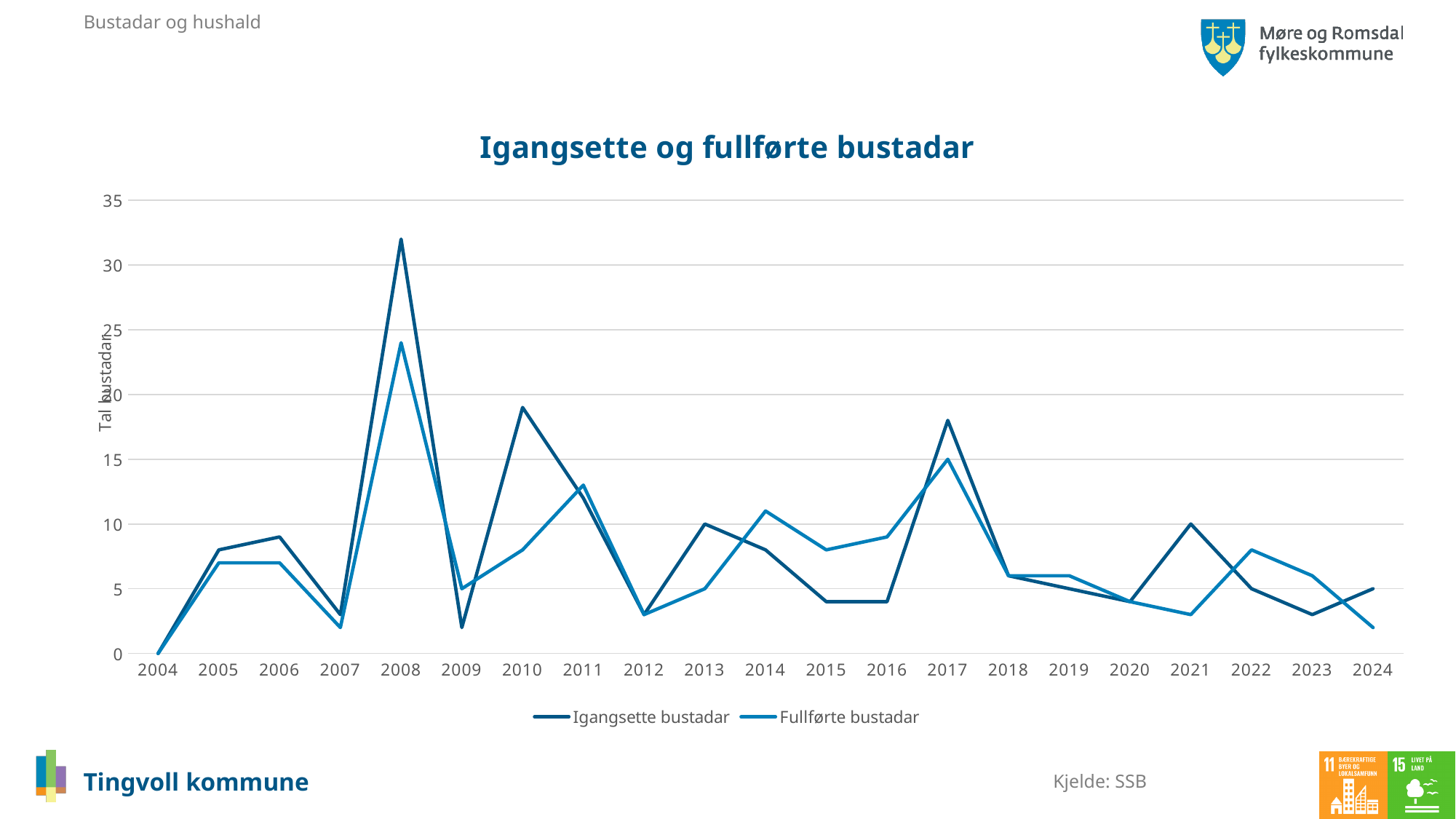
What is the value for Igangsette bustadar in 2013? 10 What kind of chart is shown on the slide? line chart What is the title of the chart? Igangsette og fullførte bustadar In which year does the Igangsette bustadar series reach its highest value? 2008 Is the value for Igangsette bustadar in 2008 greater or less than 30? greater What is the value for Fullførte bustadar in 2017? 15 In which year does the Fullførte bustadar series reach its highest value? 2008 Which series has the larger value in 2010, Igangsette bustadar or Fullførte bustadar? Igangsette bustadar Is the value for Fullførte bustadar in 2008 greater or less than 25? less Which series has the larger value in 2014, Igangsette bustadar or Fullførte bustadar? Fullførte bustadar How many series does the legend list? 2 How many years are shown on the x axis? 21